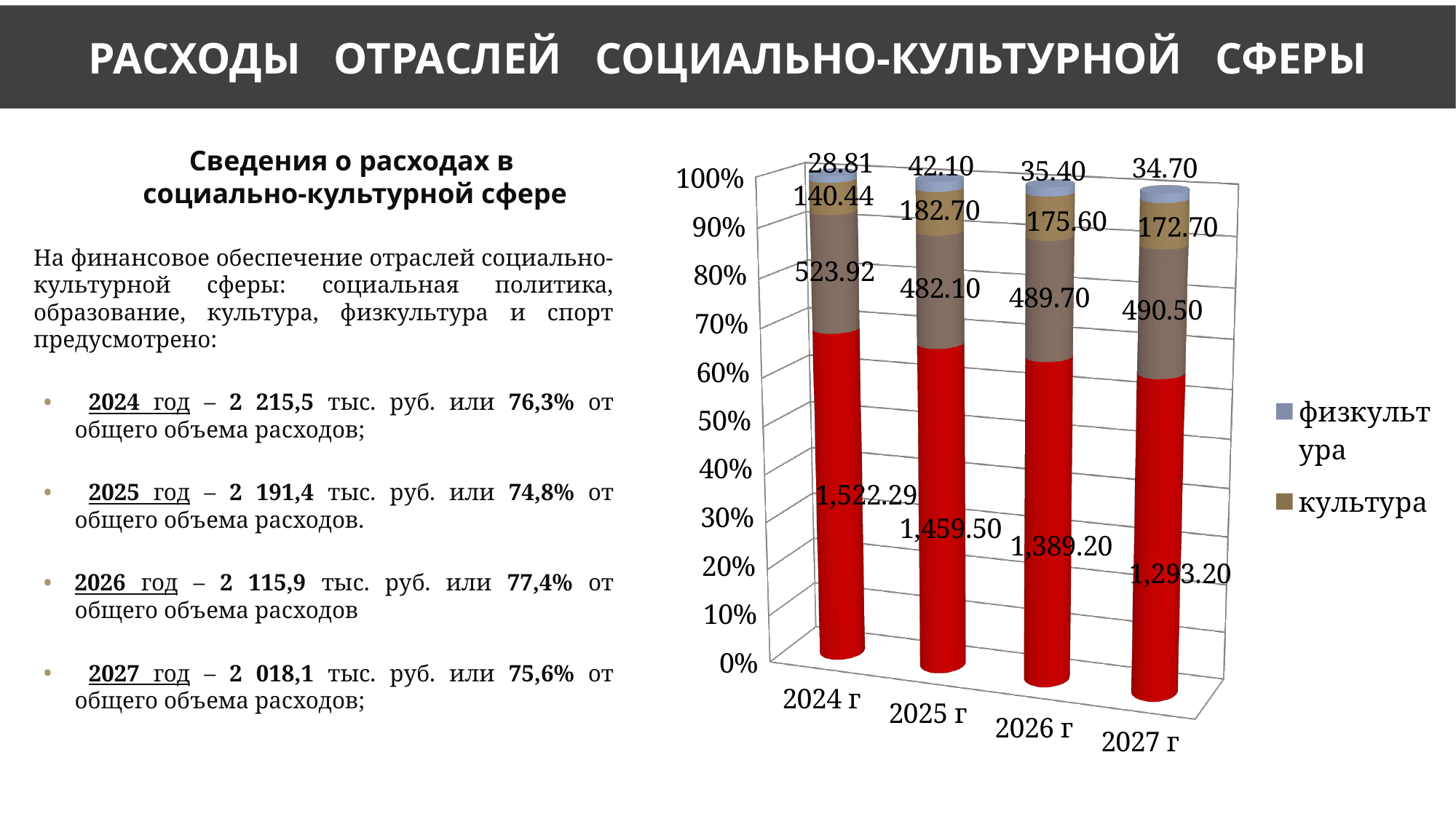
Is the bottom (red) segment of the 2024 г bar greater or less than 60% of the bar? greater What is the value of the bottom (red) segment of the bar for 2024 г? 1,522.29 In which year is the физкультура value highest? 2025 г What is the value of the bottom (red) segment of the bar for 2027 г? 1,293.20 In which year is the физкультура value lowest? 2024 г What value is shown for физкультура in 2024 г? 28.81 How many series does the chart legend list? 2 What is the difference between the физкультура values for 2025 г and 2024 г? 13.29 What kind of chart is shown on the slide? stacked bar chart Which year has the larger физкультура value, 2026 г or 2027 г? 2026 г What value is shown for физкультура in 2025 г? 42.10 How many years are shown on the x axis of the chart? 4